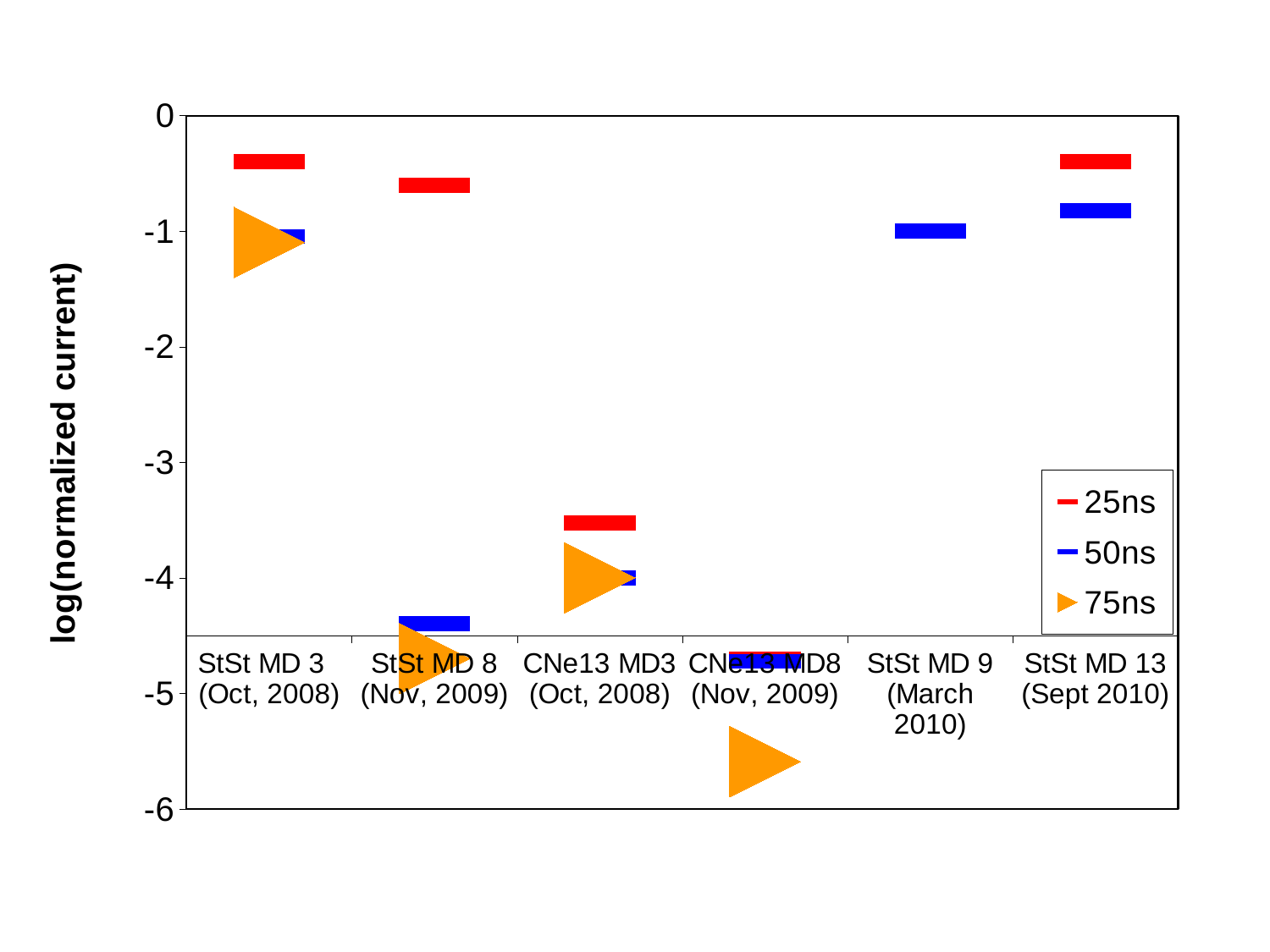
How many series does the legend list? 3 What is the label of the y axis? log(normalized current) Which category has the lowest 75ns value? CNe13 MD8 (Nov, 2009) Is the 50ns value for StSt MD 8 (Nov, 2009) greater or less than -4? less Which category has the lowest 25ns value? CNe13 MD8 (Nov, 2009) How many categories are shown along the x axis? 6 What kind of chart is shown on the slide? scatter chart Which is larger, the 25ns value for StSt MD 3 (Oct, 2008) or for CNe13 MD3 (Oct, 2008)? StSt MD 3 (Oct, 2008) Is the 25ns value for CNe13 MD3 (Oct, 2008) greater or less than -3? less Which is larger, the 50ns value for StSt MD 8 (Nov, 2009) or for StSt MD 13 (Sept 2010)? StSt MD 13 (Sept 2010) What marker shape and colour represents the 75ns series in the legend? orange triangle Is the 50ns value for StSt MD 9 (March 2010) greater or less than -2? greater